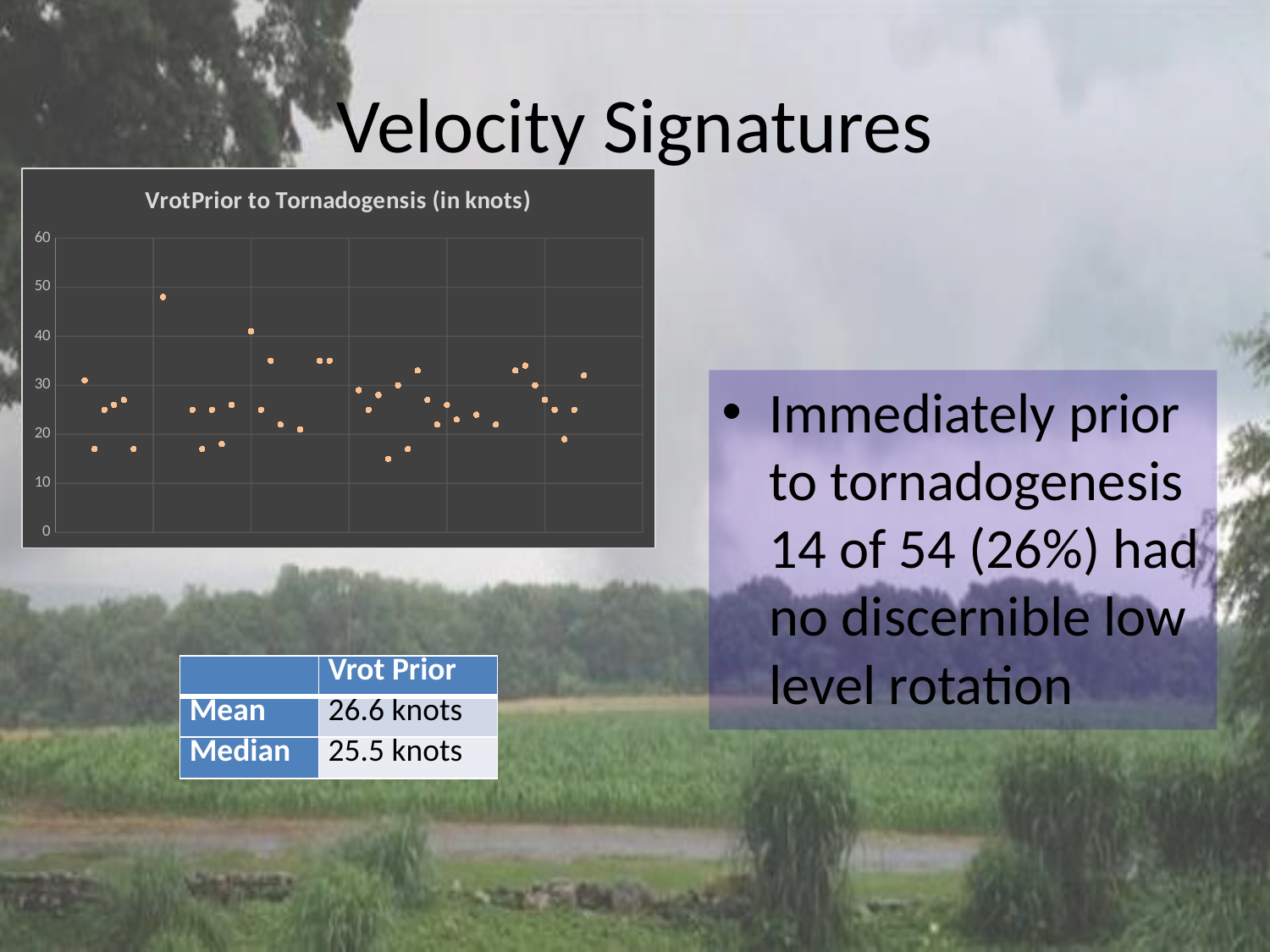
Is the highest plotted point on the chart greater or less than 40? greater What is the highest value shown on the chart's vertical axis? 60 Is the lowest plotted point on the chart greater or less than 20? less Is the highest plotted point on the chart greater or less than 50? less What is the title of the chart? VrotPrior to Tornadogensis (in knots) How many plotted points on the chart lie above 45? 1 What kind of chart is shown on the slide? scatter chart